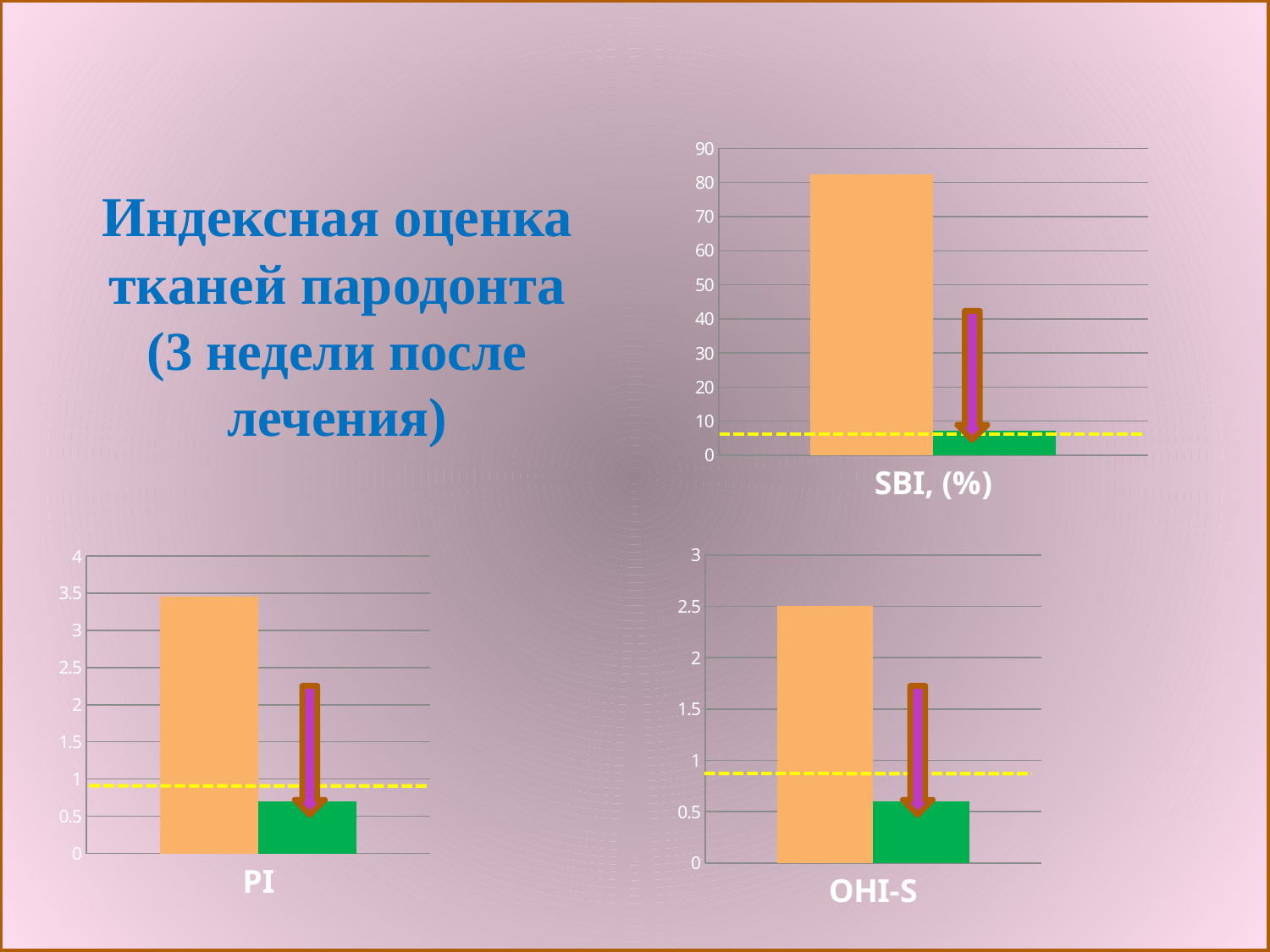
In the chart titled PI, is the value of the right (green) bar greater or less than 1? less In the chart titled OHI-S, is the value of the right (green) bar greater or less than 1? less In the chart titled SBI, (%), is the value of the left (orange) bar greater or less than 70? greater What kind of chart is the chart titled SBI, (%)? bar chart How many charts are shown on the slide? 3 In the chart titled OHI-S, what is the highest value shown on the vertical axis? 3 How many bars are plotted in the chart titled SBI, (%)? 2 In the chart titled PI, which bar has the highest value? the left orange bar In the chart titled SBI, (%), which bar is taller, the left orange bar or the right green bar? the left orange bar